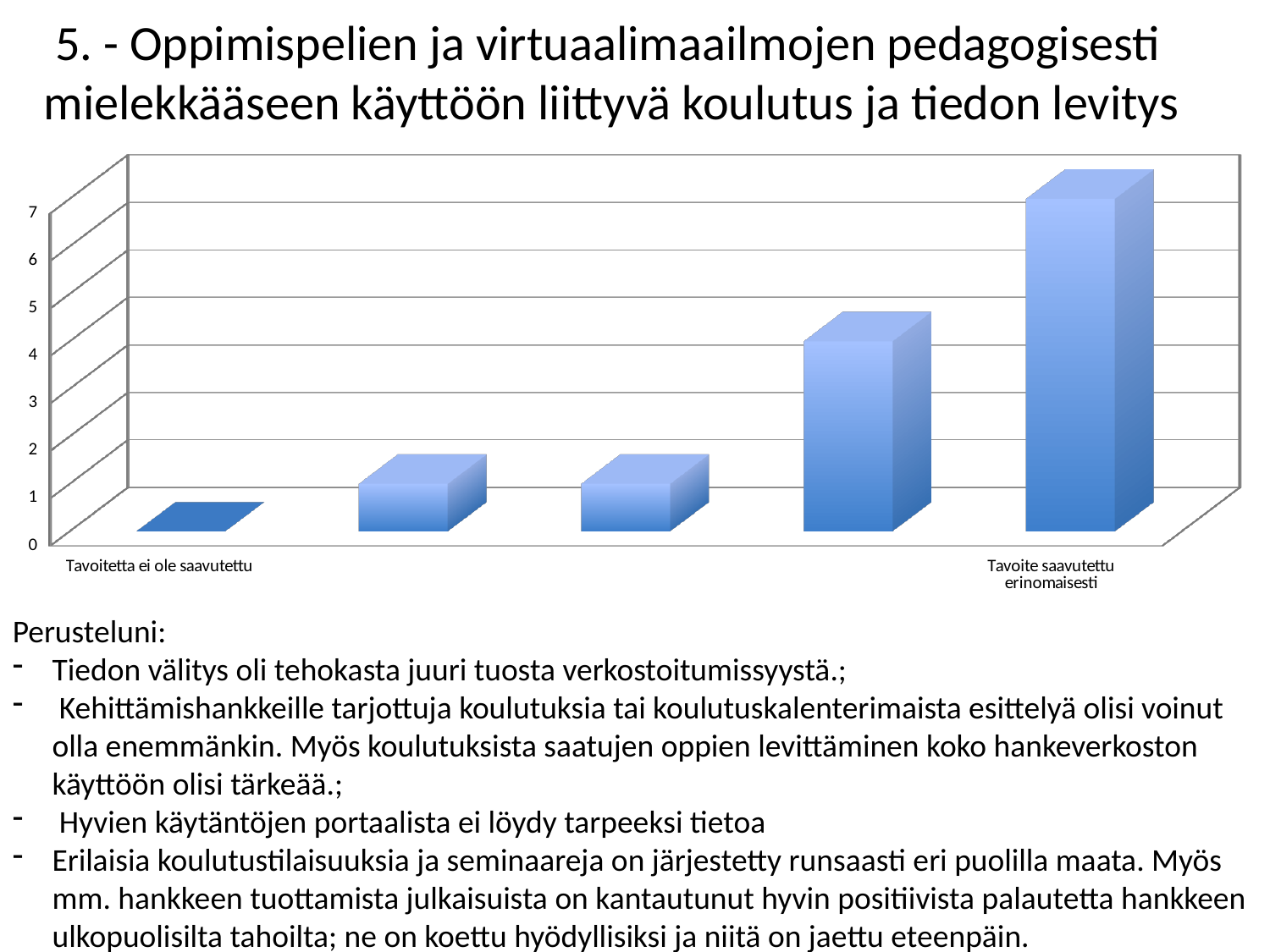
What is the highest tick value shown on the vertical axis? 7 Do the bar values generally rise or fall from left to right along the x axis? rise Which is larger, the value for 'Tavoitetta ei ole saavutettu' or the value for 'Tavoite saavutettu erinomaisesti'? Tavoite saavutettu erinomaisesti Is the value for 'Tavoite saavutettu erinomaisesti' greater or less than 5? greater What kind of chart is shown on the slide? bar chart What is the label of the leftmost category on the x axis? Tavoitetta ei ole saavutettu Which category has the highest bar? Tavoite saavutettu erinomaisesti How many bars does the chart contain? 5 Which category has the lowest bar? Tavoitetta ei ole saavutettu Is the value for 'Tavoitetta ei ole saavutettu' greater or less than 1? less